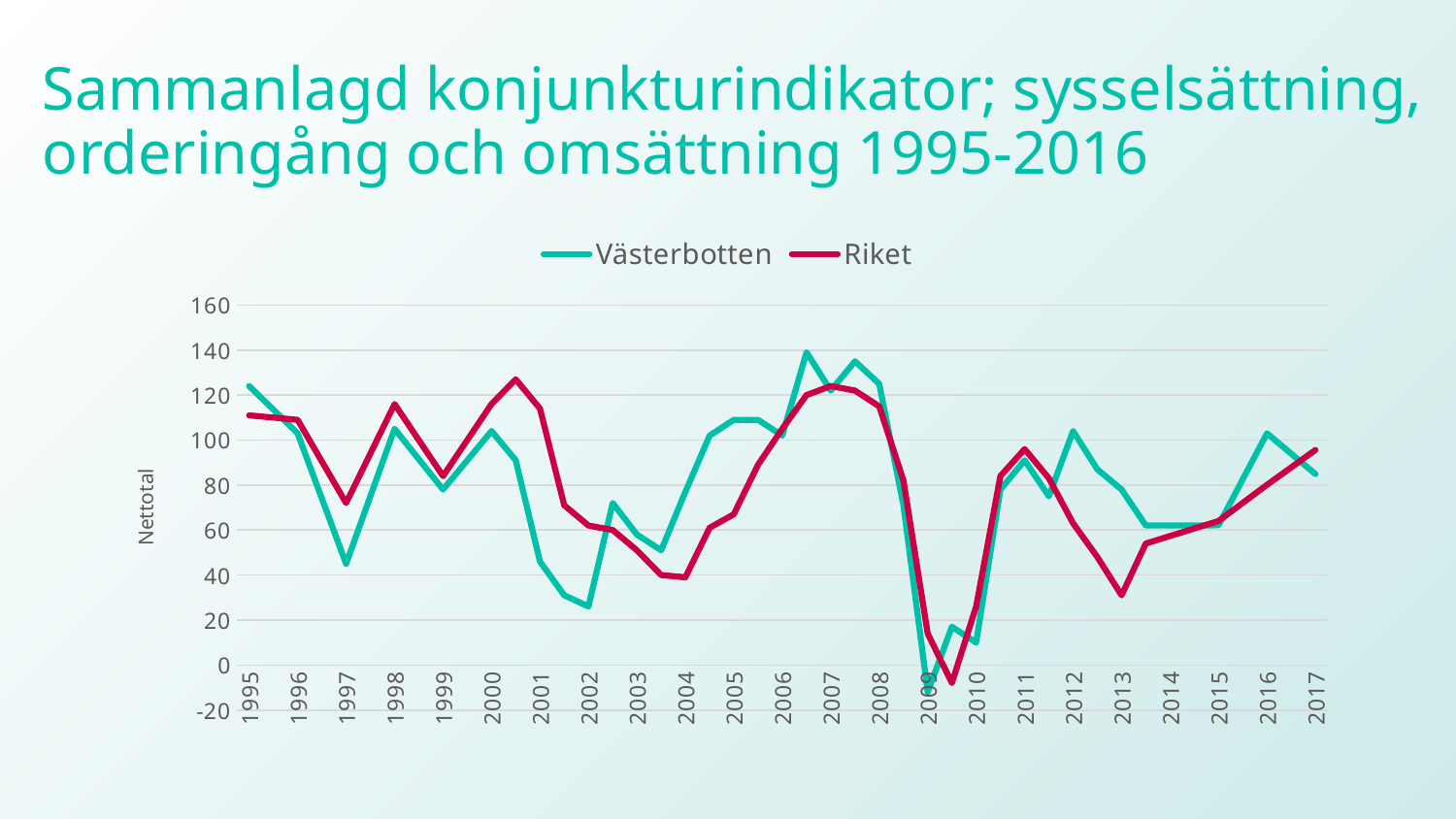
Is the value for Riket in 1998 greater or less than 100? greater Is the value for Västerbotten in 1997 greater or less than 60? less What is the label on the vertical axis? Nettotal In 1997, which series has the larger value, Västerbotten or Riket? Riket In 2013, which series has the larger value, Västerbotten or Riket? Västerbotten Is the value for Västerbotten in 2002 greater or less than 40? less How many series does the legend list? 2 In which year does the Riket series reach its lowest value? 2009 What kind of chart is shown on the slide? line chart Which two series are shown in the legend? Västerbotten and Riket How many years are labelled along the x axis? 23